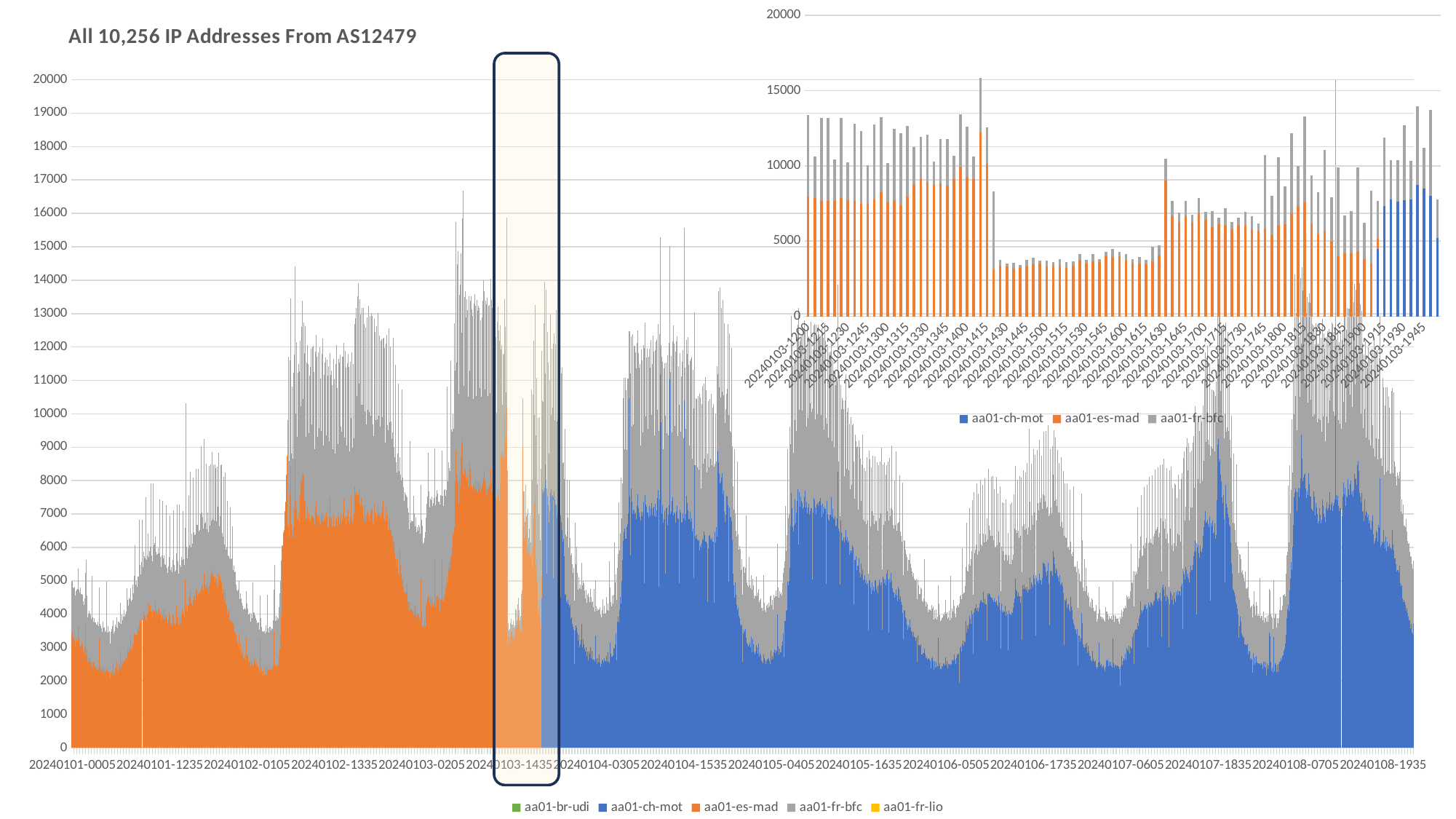
What kind of chart is the large chart titled 'All 10,256 IP Addresses From AS12479'? bar chart What is the highest value shown on the y axis of the large chart 'All 10,256 IP Addresses From AS12479'? 20000 In the inset chart in the top right, do the stacked totals generally rise or fall from 20240103-1430 to 20240103-1945? rise What is the title of the large chart on the left of the slide? All 10,256 IP Addresses From AS12479 In the inset chart in the top right, is the stacked total at 20240103-1945 greater or less than 5000? greater How many series does the legend of the large chart 'All 10,256 IP Addresses From AS12479' list? 5 How many series does the legend of the inset chart in the top right list? 3 What kind of chart is the inset chart in the top right of the slide? bar chart In the inset chart in the top right, is the tallest stacked bar near 20240103-1415 greater or less than 15000? greater In the large chart 'All 10,256 IP Addresses From AS12479', which colour represents the series aa01-fr-bfc? gray In the inset chart in the top right, is the stacked total at 20240103-1445 greater or less than 5000? less